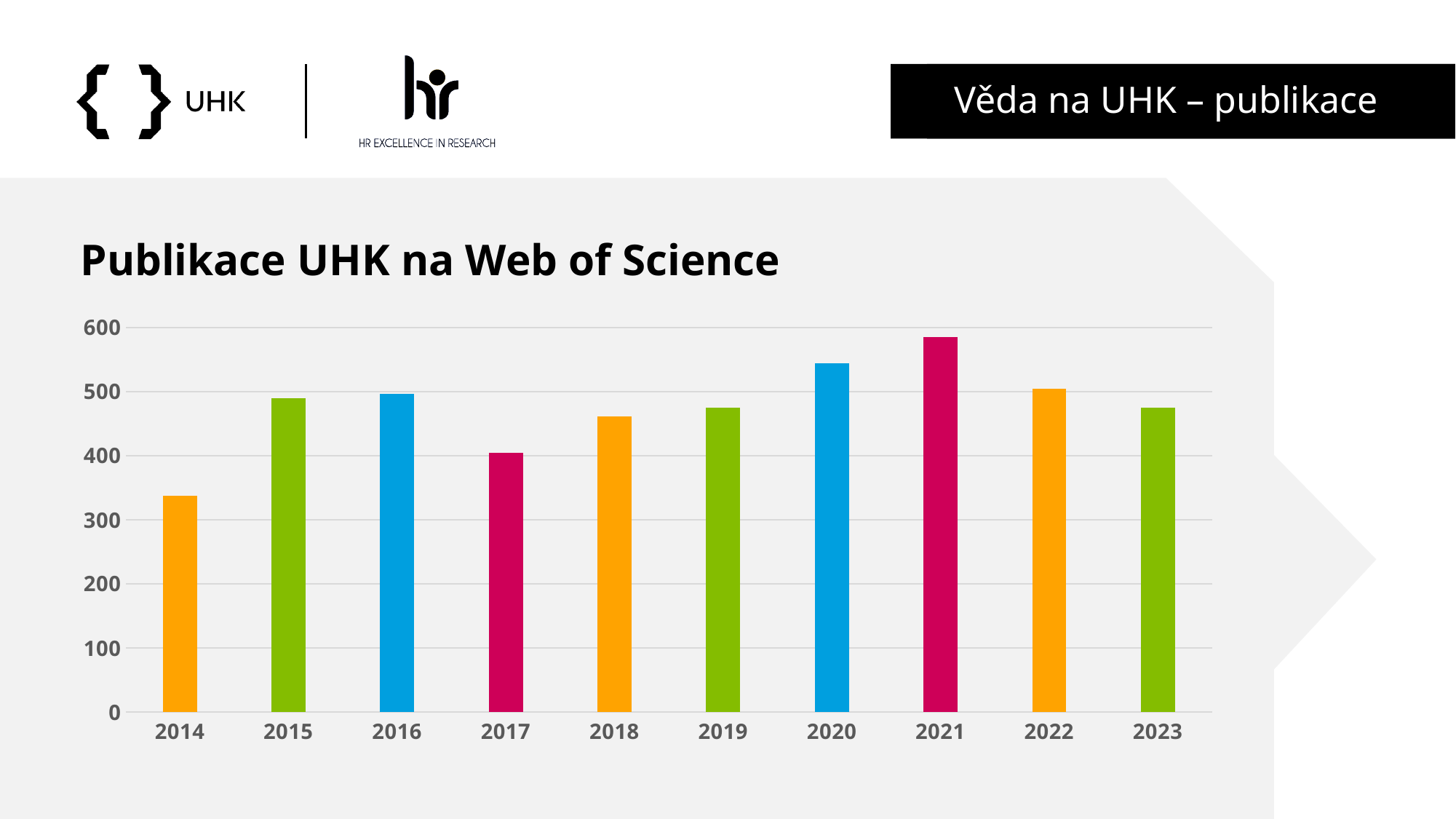
Is the value for 2018 greater or less than 500? less Which year has the larger value, 2017 or 2020? 2020 Is the value for 2020 greater or less than 500? greater Which year has the highest number of publications? 2021 Is the value for 2014 greater or less than 400? less Do the values rise or fall from 2021 to 2023? fall Which year has the lowest number of publications? 2014 How many years are shown on the x axis of the chart? 10 What type of chart is shown on the slide? bar chart Which year has the larger value, 2014 or 2018? 2018 What is the title of the chart? Publikace UHK na Web of Science